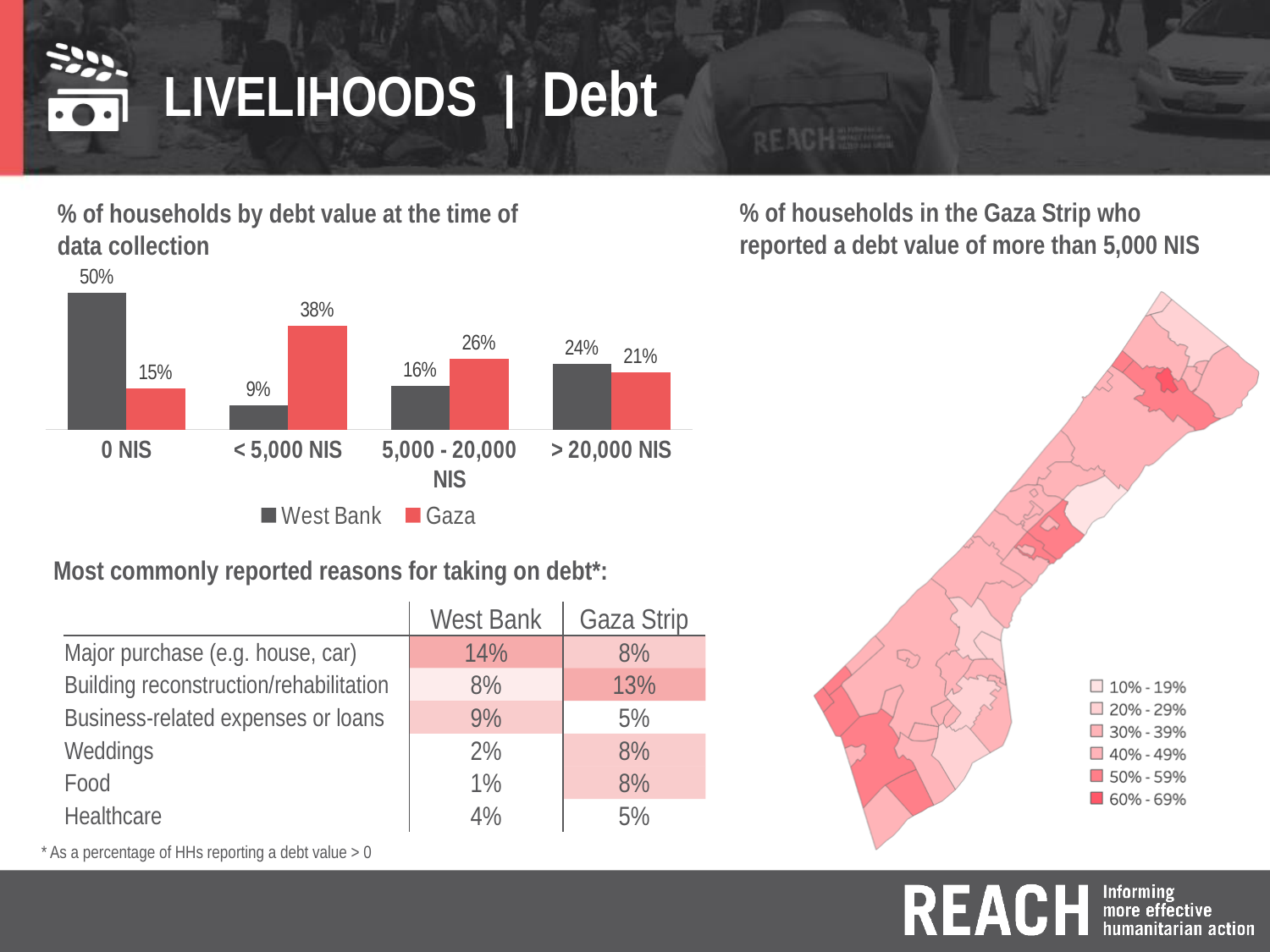
In the chart '% of households by debt value at the time of data collection', which debt value category has the lowest value for Gaza? 0 NIS In the chart '% of households by debt value at the time of data collection', which series has the larger value in the > 20,000 NIS category, West Bank or Gaza? West Bank In the chart '% of households by debt value at the time of data collection', what is the value for Gaza in the < 5,000 NIS category? 38% How many debt value categories are shown in the chart '% of households by debt value at the time of data collection'? 4 In the chart '% of households by debt value at the time of data collection', what is the value for West Bank in the 0 NIS category? 50% In the chart '% of households by debt value at the time of data collection', which debt value category has the highest value for West Bank? 0 NIS In the chart '% of households by debt value at the time of data collection', what is the value for West Bank in the > 20,000 NIS category? 24% In the chart '% of households by debt value at the time of data collection', which colour represents Gaza in the legend? Red In the chart '% of households by debt value at the time of data collection', what is the difference between the West Bank and Gaza values in the < 5,000 NIS category? 29% In the chart '% of households by debt value at the time of data collection', what is the value for Gaza in the 5,000 - 20,000 NIS category? 26% How many series does the legend list in the chart '% of households by debt value at the time of data collection'? 2 What kind of chart is '% of households by debt value at the time of data collection'? Bar chart